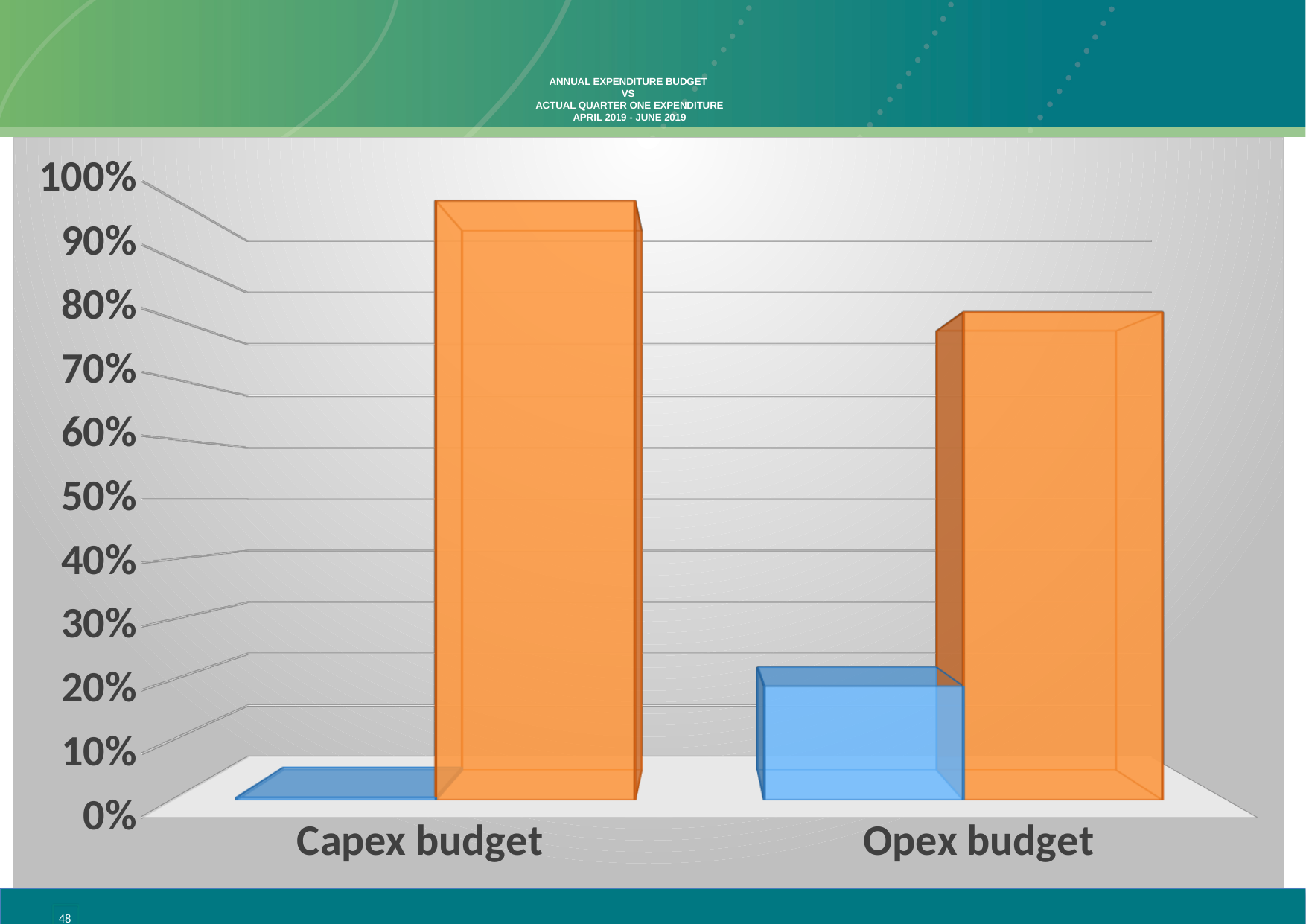
Is the value of the blue bar for Opex budget greater or less than 30%? less What is the highest percentage tick shown on the vertical axis of the chart? 100% Is the value of the blue bar for Capex budget greater or less than 10%? less Which category has the taller orange bar, Capex budget or Opex budget? Capex budget Which category has the taller blue bar, Capex budget or Opex budget? Opex budget Is the value of the orange bar for Opex budget greater or less than 50%? greater Which bar on the chart is the tallest overall? the orange bar for Capex budget What are the two categories shown on the x axis of the chart? Capex budget and Opex budget What kind of chart is shown on the slide? bar chart How many categories are shown on the x axis of the chart? 2